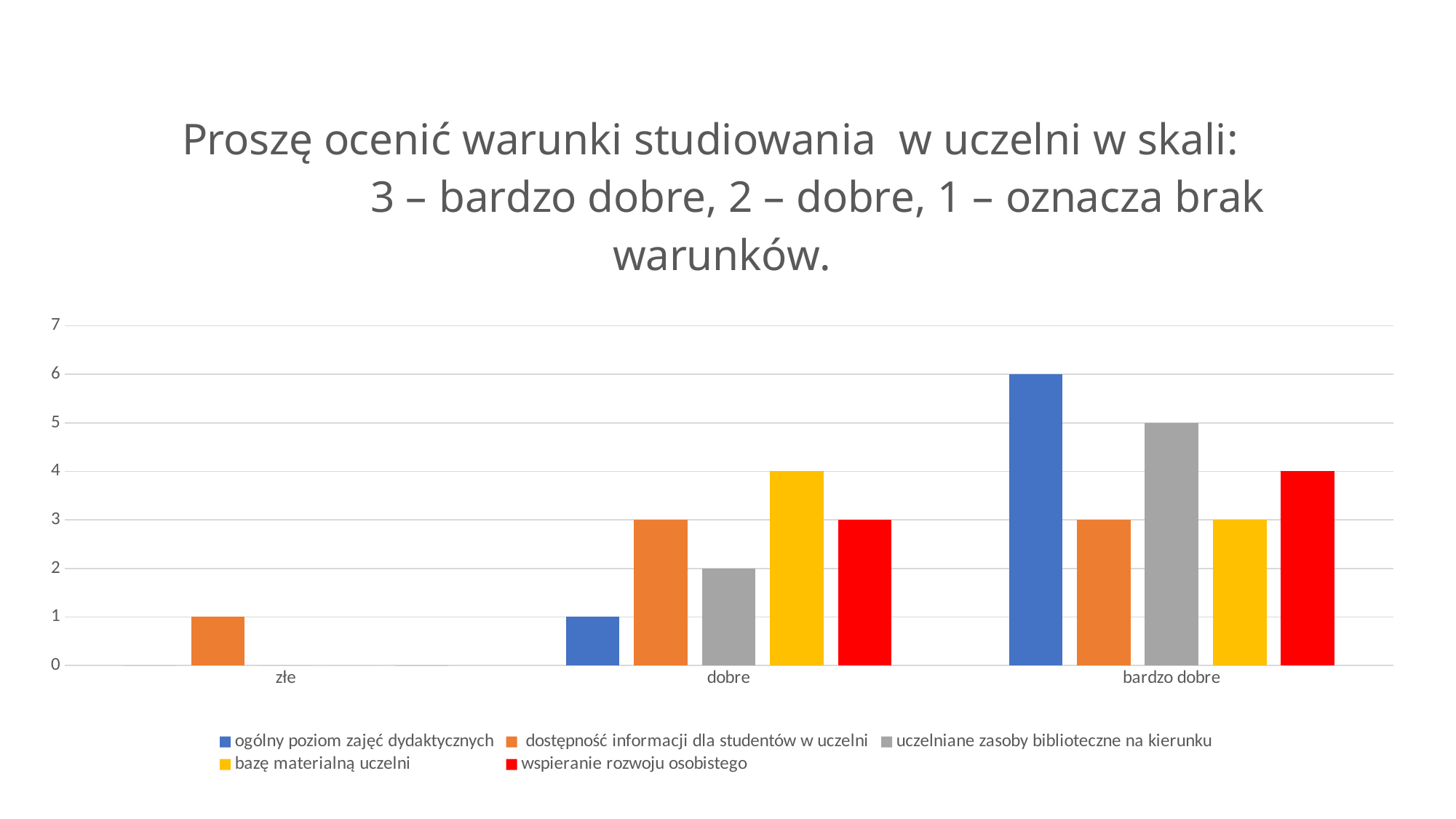
What is the difference between the 'ogólny poziom zajęć dydaktycznych' values for 'bardzo dobre' and 'dobre'? 5 What is the value for 'dostępność informacji dla studentów w uczelni' in the 'złe' category? 1 What is the value for 'ogólny poziom zajęć dydaktycznych' in the 'bardzo dobre' category? 6 Which series has the lowest value in the 'dobre' category? ogólny poziom zajęć dydaktycznych How many series does the legend list? 5 Which colour represents 'wspieranie rozwoju osobistego' in the legend? red What kind of chart is shown on the slide? bar chart What is the value for 'uczelniane zasoby biblioteczne na kierunku' in the 'bardzo dobre' category? 5 Which is larger: 'wspieranie rozwoju osobistego' in 'bardzo dobre' or 'bazę materialną uczelni' in 'bardzo dobre'? wspieranie rozwoju osobistego What is the value for 'bazę materialną uczelni' in the 'dobre' category? 4 How many categories are shown on the x axis? 3 Which series has the highest value in the 'bardzo dobre' category? ogólny poziom zajęć dydaktycznych